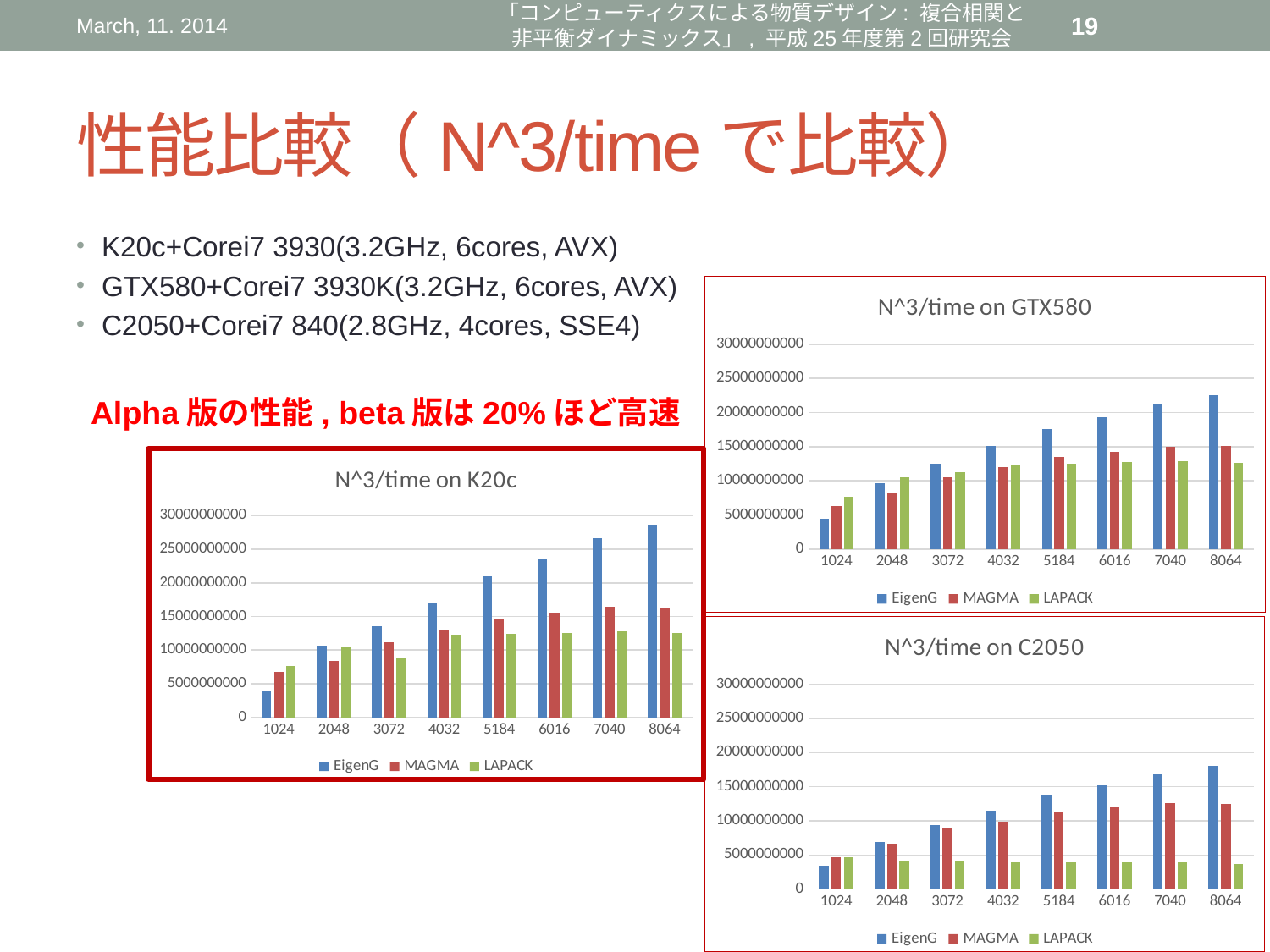
In "N^3/time on K20c", is the EigenG value at 1024 greater or less than 5000000000? less In "N^3/time on GTX580", is the EigenG value at 8064 greater or less than 20000000000? greater How many series does the legend of "N^3/time on GTX580" list? 3 What kind of chart is "N^3/time on K20c"? bar chart In "N^3/time on C2050", is the LAPACK value at 8064 greater or less than 5000000000? less In "N^3/time on C2050", which is larger at 1024: EigenG or MAGMA? MAGMA In "N^3/time on GTX580", do the EigenG values rise or fall as the matrix size increases along the x axis? rise In "N^3/time on K20c", at which matrix size is the EigenG bar highest? 8064 In "N^3/time on K20c", which is larger at 8064: EigenG or LAPACK? EigenG In "N^3/time on K20c", at which matrix size is the EigenG bar lowest? 1024 How many matrix-size categories are shown on the x axis of "N^3/time on C2050"? 8